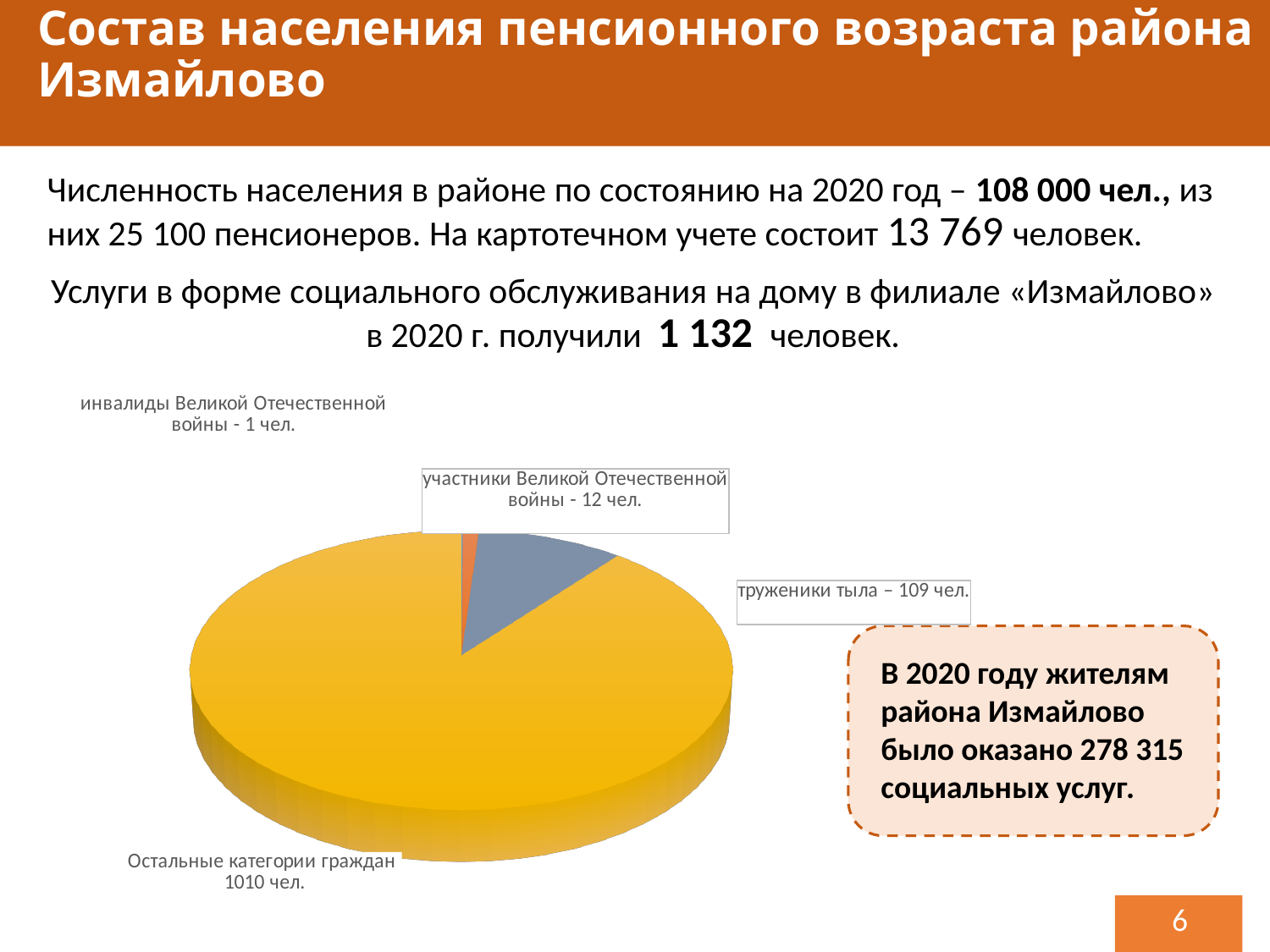
Which is larger on the pie chart: 'труженики тыла' or 'участники Великой Отечественной войны'? труженики тыла What kind of chart is shown on the slide? pie chart How many people are in the category 'Остальные категории граждан' on the pie chart? 1010 чел. Which category has the largest slice of the pie chart? Остальные категории граждан How many people are in the category 'инвалиды Великой Отечественной войны' on the pie chart? 1 чел. What is the total of all four categories shown on the pie chart? 1132 How many people are in the category 'участники Великой Отечественной войны' on the pie chart? 12 чел. What is the difference between the number of 'труженики тыла' and 'участники Великой Отечественной войны' on the pie chart? 97 Which category has the smallest slice of the pie chart? инвалиды Великой Отечественной войны What colour is the largest slice of the pie chart? yellow How many categories does the pie chart show? 4 How many people are in the category 'труженики тыла' on the pie chart? 109 чел.